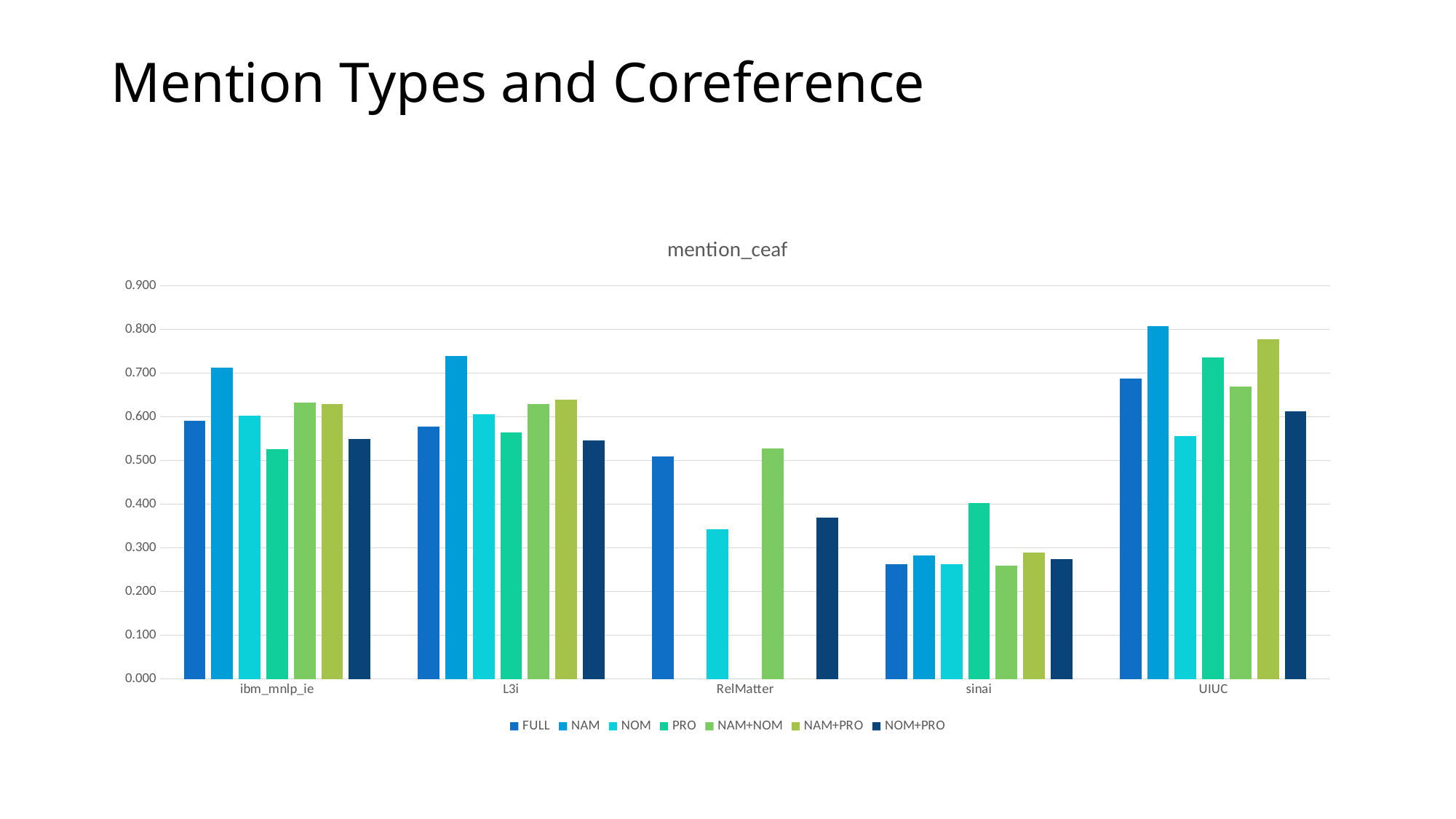
For UIUC, which series has the highest value? NAM How many series does the legend list? 7 How many systems (categories) are shown on the x axis? 5 Is the FULL value for sinai greater or less than 0.300? less Is the NOM value for RelMatter greater or less than 0.400? less Which system has the highest NAM value? UIUC What is the title of the chart? mention_ceaf For ibm_mnlp_ie, which is larger: the NAM value or the FULL value? NAM What kind of chart is shown on the slide? bar chart For sinai, which is larger: the PRO value or the NAM value? PRO Is the NAM value for L3i greater or less than 0.700? greater Which system has the lowest FULL value? sinai